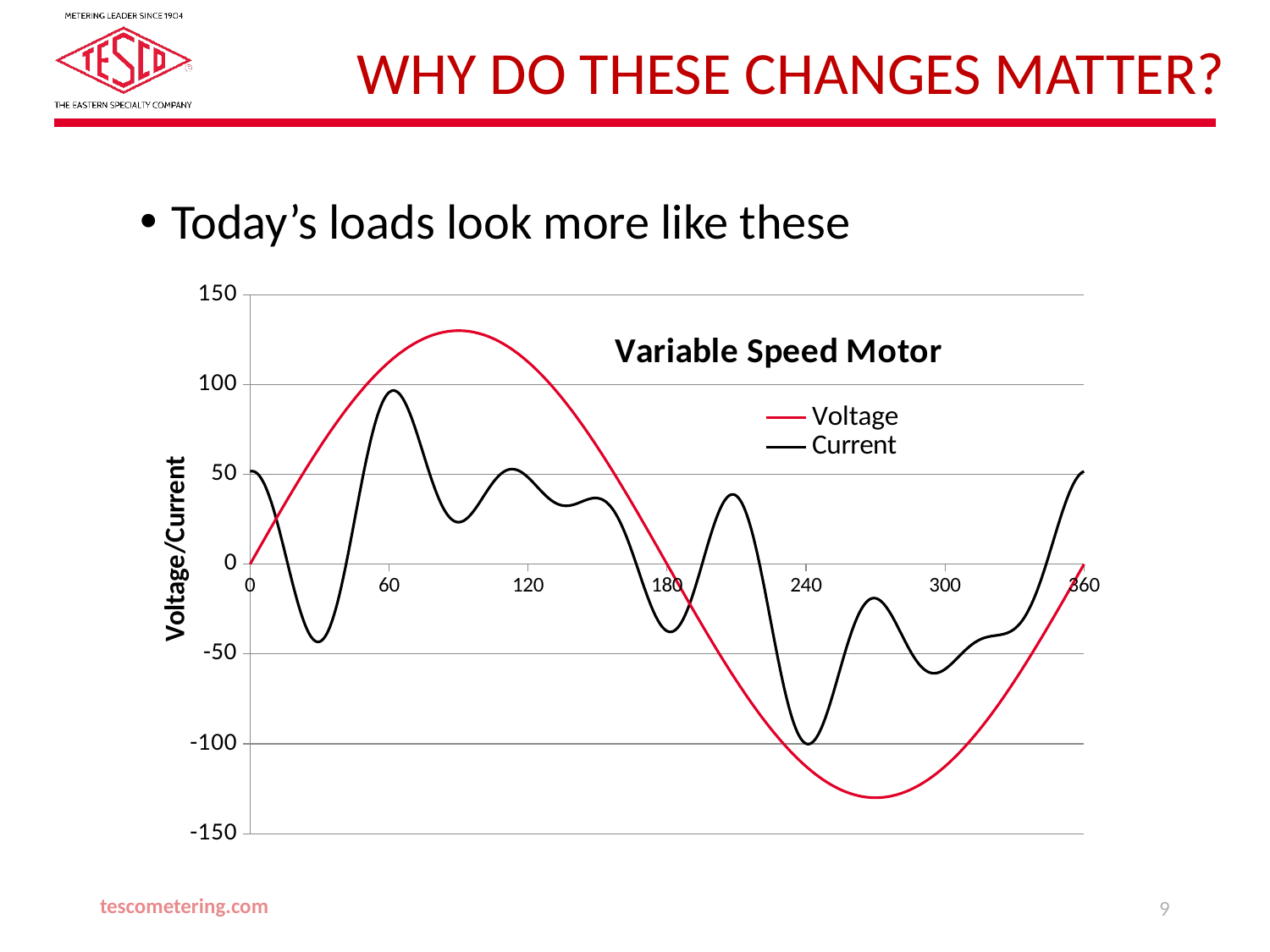
Is the peak value of the Voltage series greater or less than 100? greater Does the Voltage series rise or fall between x = 90 and x = 270? fall Is the lowest value of the Voltage series greater or less than -100? less Is the value of the Current series at x = 240 greater or less than -50? less At x = 90, which series has the higher value, Voltage or Current? Voltage What kind of chart is shown on the slide? line chart Which colour is used for the Current series in the chart? black How many series does the legend of the chart list? 2 What is the title of the chart? Variable Speed Motor What is the value of the Voltage series at x = 0? 0 At x = 270, which series has the lower value, Voltage or Current? Voltage